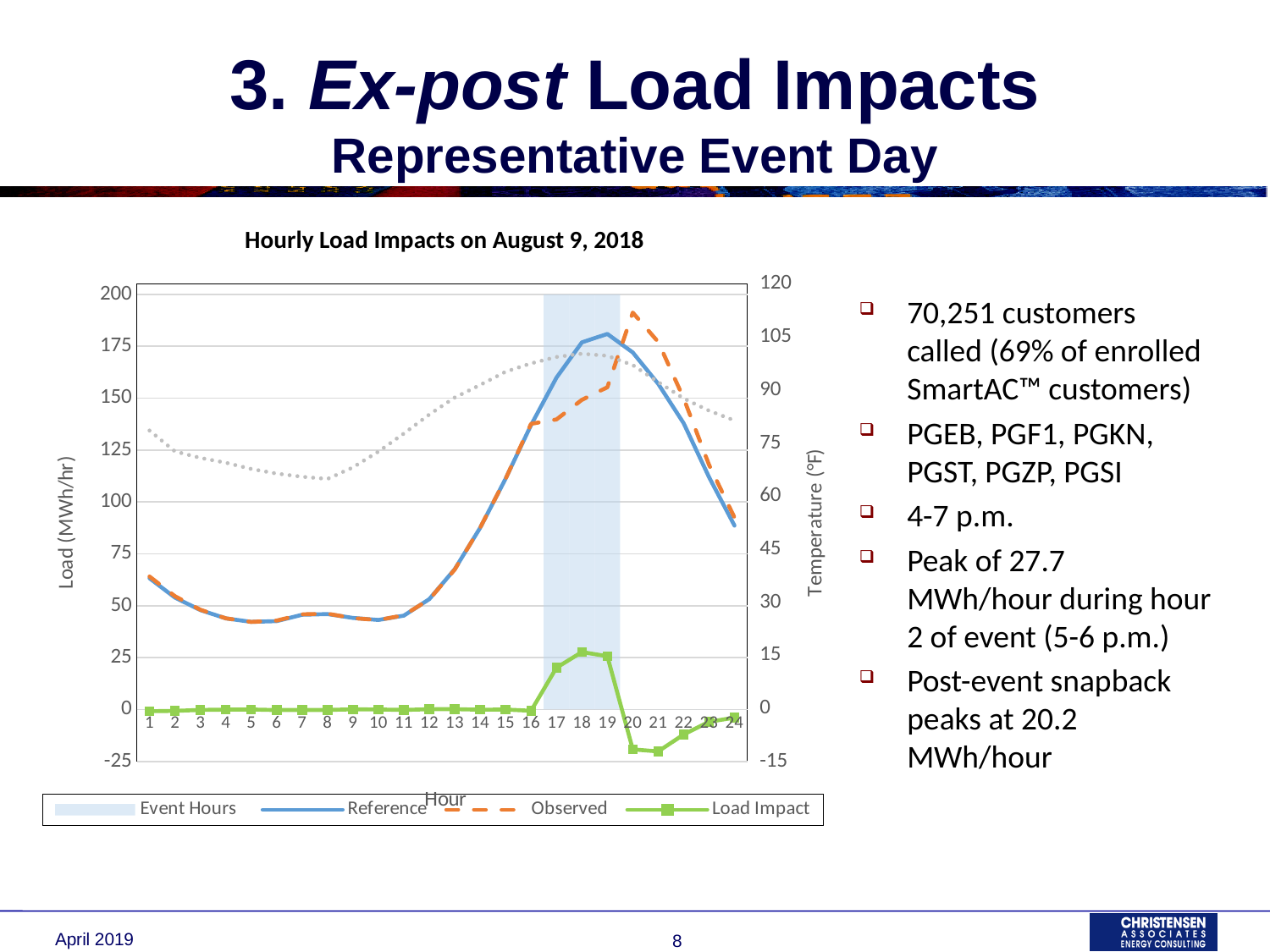
How many entries does the chart's legend list? 4 How many hours are plotted along the x axis of the chart? 24 At which hour does the Reference line reach its highest value? 19 What is the label of the left vertical axis? Load (MWh/hr) What kind of chart is shown on the slide? combination bar and line chart At hour 20, which is larger, the Observed value or the Reference value? Observed Is the Load Impact value at hour 21 greater or less than 0? less Does the Reference line rise or fall from hour 10 to hour 19? rise Is the Observed value at hour 20 greater or less than 175? greater At which hour does the Load Impact line reach its highest value? 18 At hour 18, which is larger, the Reference value or the Observed value? Reference What is the title of the chart? Hourly Load Impacts on August 9, 2018